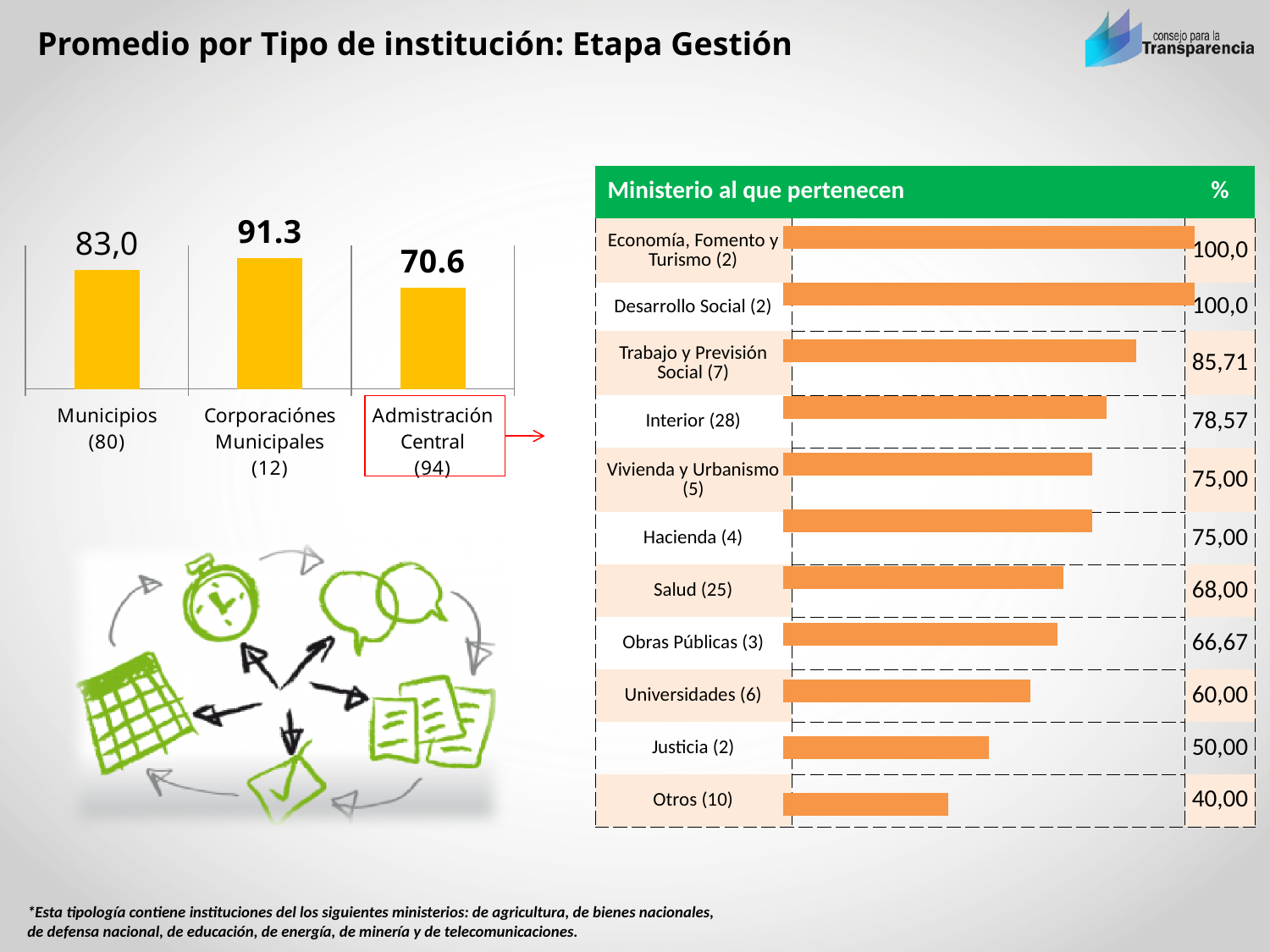
In the left bar chart, which category has the lowest value? Admistración Central (94) In the right chart 'Ministerio al que pertenecen', what is the difference between Trabajo y Previsión Social (7) and Interior (28)? 7,14 In the right chart 'Ministerio al que pertenecen', what is the value for Interior (28)? 78,57 In the left bar chart, what is the value for Municipios (80)? 83,0 In the right chart 'Ministerio al que pertenecen', which category has the lowest value? Otros (10) In the right chart 'Ministerio al que pertenecen', which is larger, Universidades (6) or Obras Públicas (3)? Obras Públicas (3) In the right chart 'Ministerio al que pertenecen', what is the value for Salud (25)? 68,00 How many categories are listed in the right chart 'Ministerio al que pertenecen'? 11 What kind of chart is the left chart? Bar chart In the left bar chart, which category has the highest value? Corporaciónes Municipales (12) How many categories are shown in the left bar chart? 3 In the left bar chart, what is the value for Corporaciones Municipales (12)? 91.3